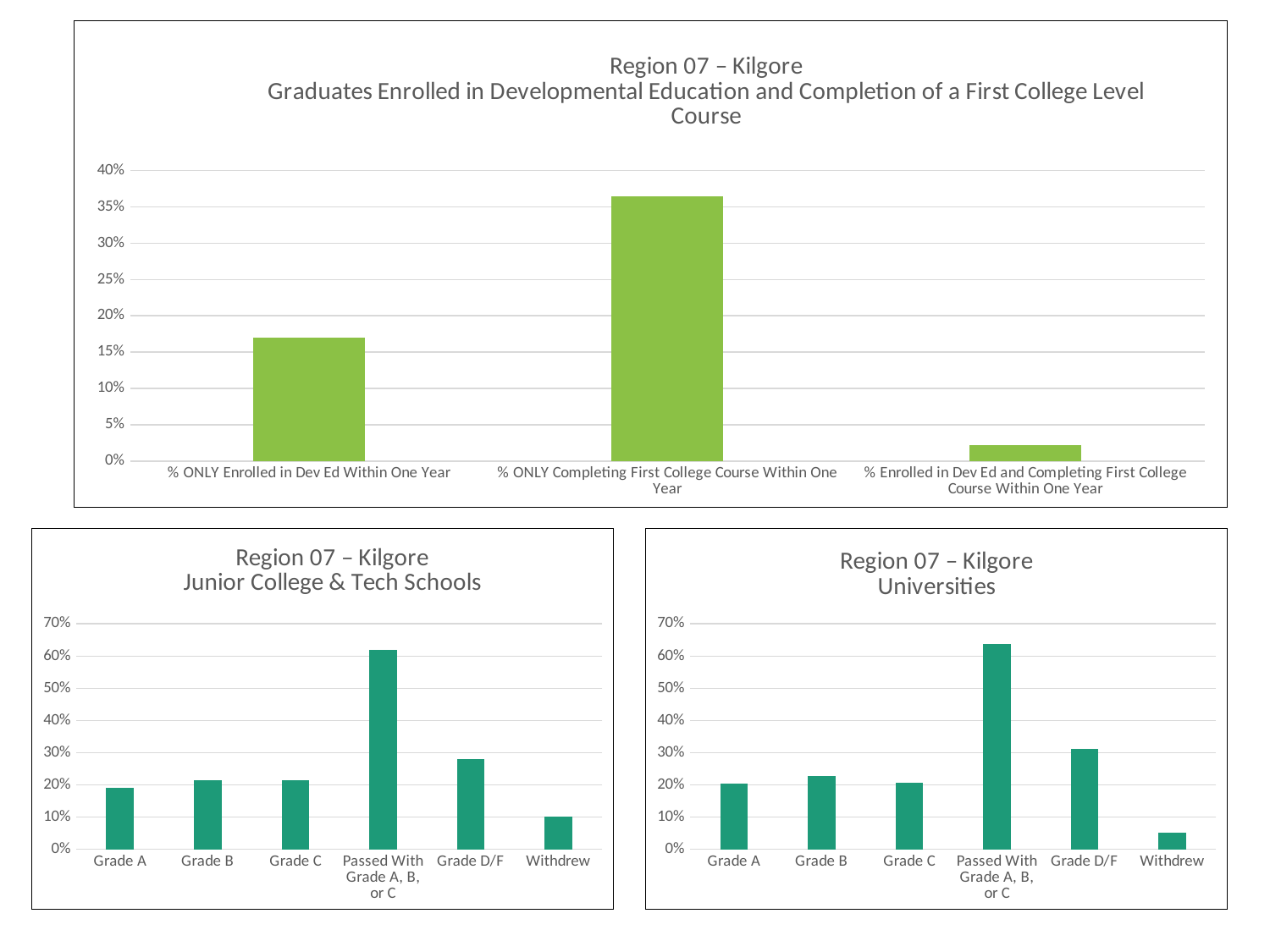
In the bottom-right chart 'Region 07 – Kilgore Universities', which category has the lowest value? Withdrew In the top chart (Graduates Enrolled in Developmental Education), is the value for '% ONLY Completing First College Course Within One Year' greater or less than 30%? greater In the top chart (Graduates Enrolled in Developmental Education), is the value for '% ONLY Enrolled in Dev Ed Within One Year' greater or less than 15%? greater In the bottom-right chart 'Region 07 – Kilgore Universities', is the value for 'Passed With Grade A, B, or C' greater or less than 50%? greater In the top chart (Graduates Enrolled in Developmental Education), which category has the highest value? % ONLY Completing First College Course Within One Year In the bottom-left chart 'Region 07 – Kilgore Junior College & Tech Schools', which category has the highest value? Passed With Grade A, B, or C What kind of chart is the top chart titled 'Region 07 – Kilgore Graduates Enrolled in Developmental Education and Completion of a First College Level Course'? Bar chart How many categories are shown in the top chart (Graduates Enrolled in Developmental Education)? 3 In the bottom-left chart 'Region 07 – Kilgore Junior College & Tech Schools', which category has the lowest value? Withdrew In the bottom-right chart 'Region 07 – Kilgore Universities', which is larger, the value for Grade D/F or the value for Grade B? Grade D/F In the top chart (Graduates Enrolled in Developmental Education), which category has the lowest value? % Enrolled in Dev Ed and Completing First College Course Within One Year